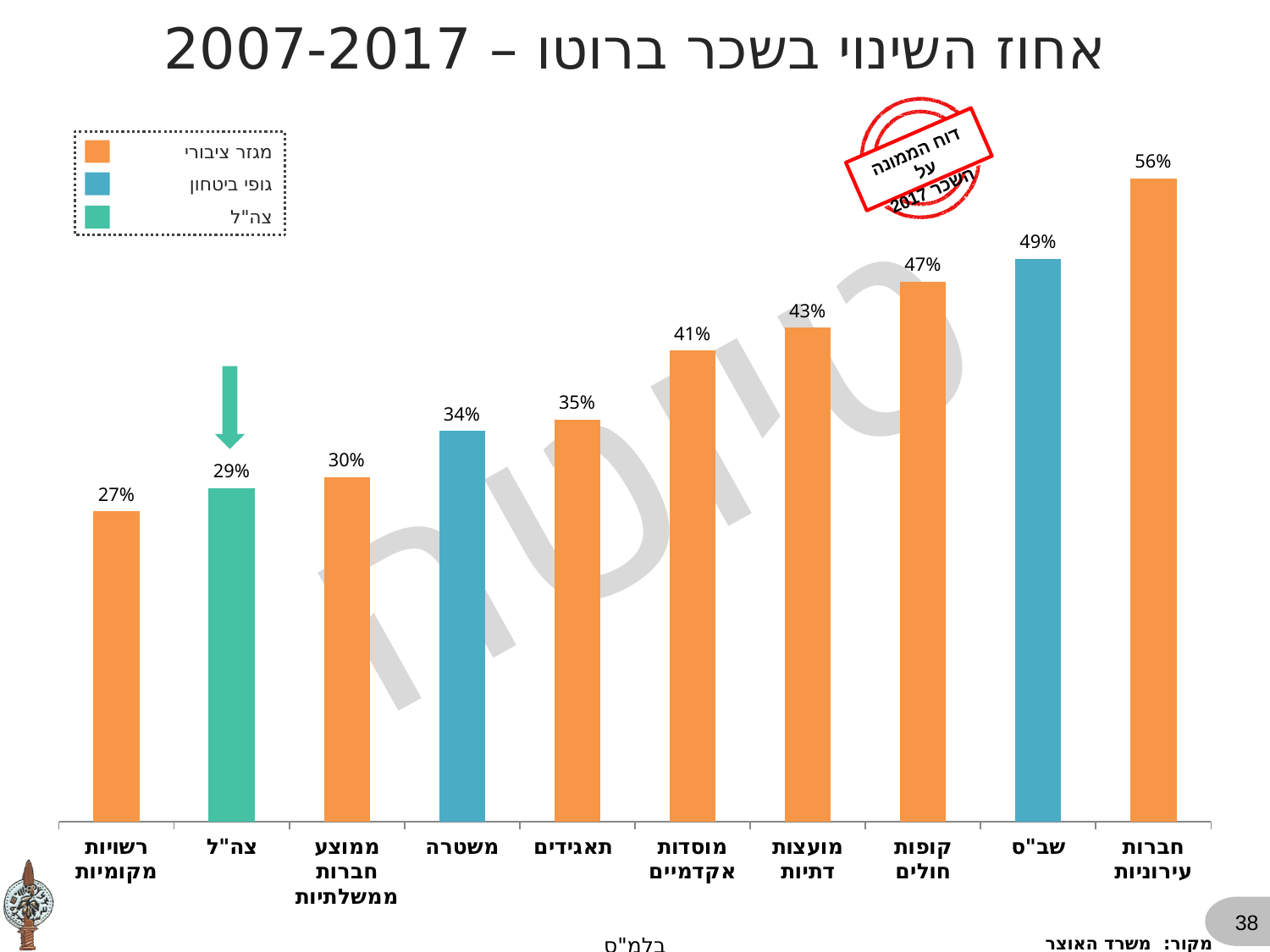
What is the value for צה"ל? 29% Which category has the highest value? חברות עירוניות How many categories are shown on the chart? 10 What is the value for שב"ס? 49% Which is larger, the value for מועצות דתיות or the value for תאגידים? מועצות דתיות What kind of chart is shown on the slide? bar chart How many entries does the legend list? 3 What is the difference between the values for קופות חולים and משטרה? 13% What is the difference between the values for חברות עירוניות and רשויות מקומיות? 29% Which category has the lowest value? רשויות מקומיות What is the value for מוסדות אקדמיים? 41% Which legend entry is shown in green? צה"ל